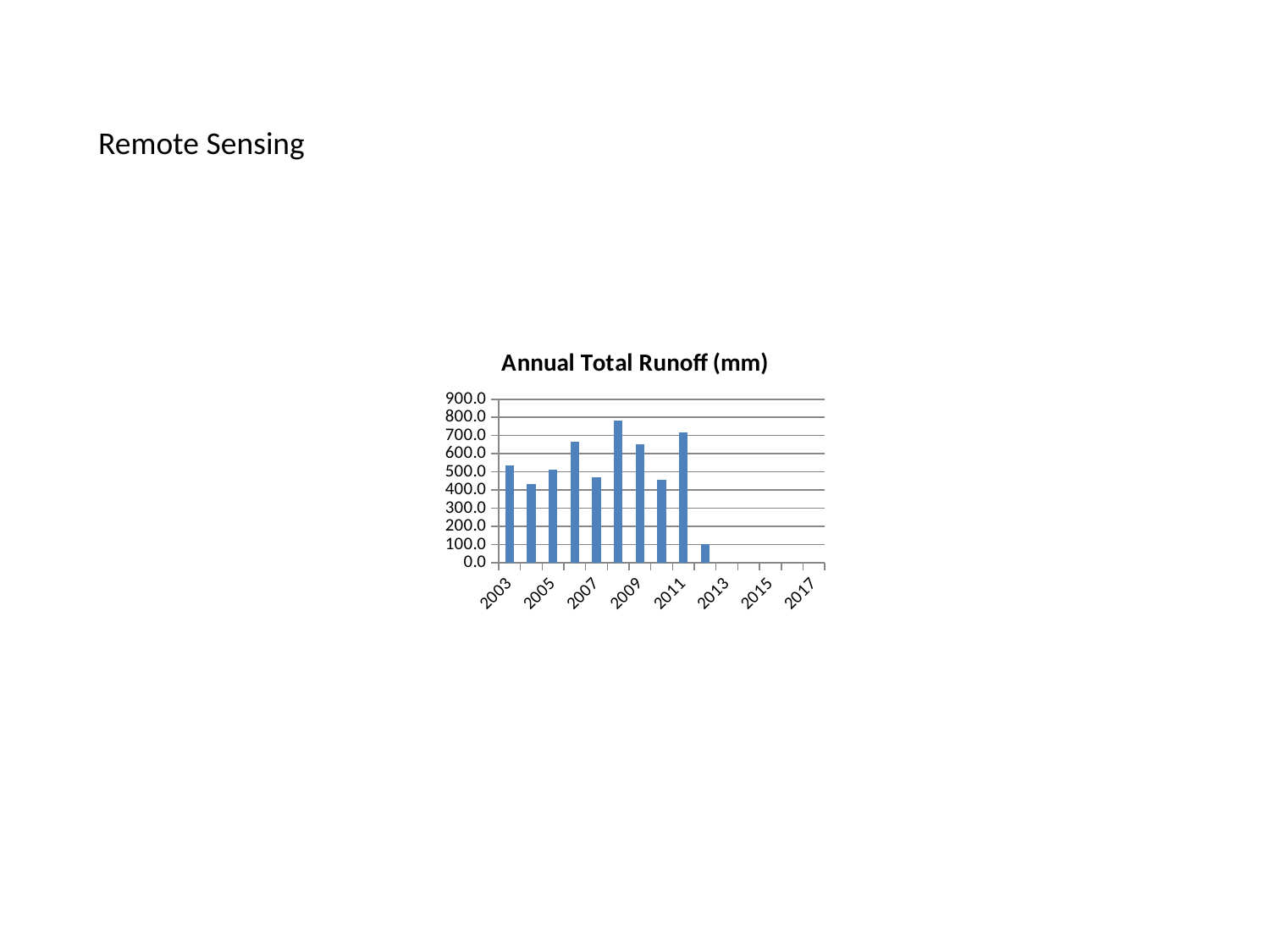
Which year with a bar has the lowest annual total runoff? 2012 Which year has the highest annual total runoff? 2008 Which is larger, the value for 2006 or the value for 2007? 2006 Is the value for 2010 greater or less than 500? less Is the value for 2003 greater or less than 500? greater Which is larger, the value for 2008 or the value for 2011? 2008 Is the value for 2006 greater or less than 600? greater What is the title of the chart? Annual Total Runoff (mm) How many bars are plotted in the chart? 10 What kind of chart is shown on the slide? bar chart